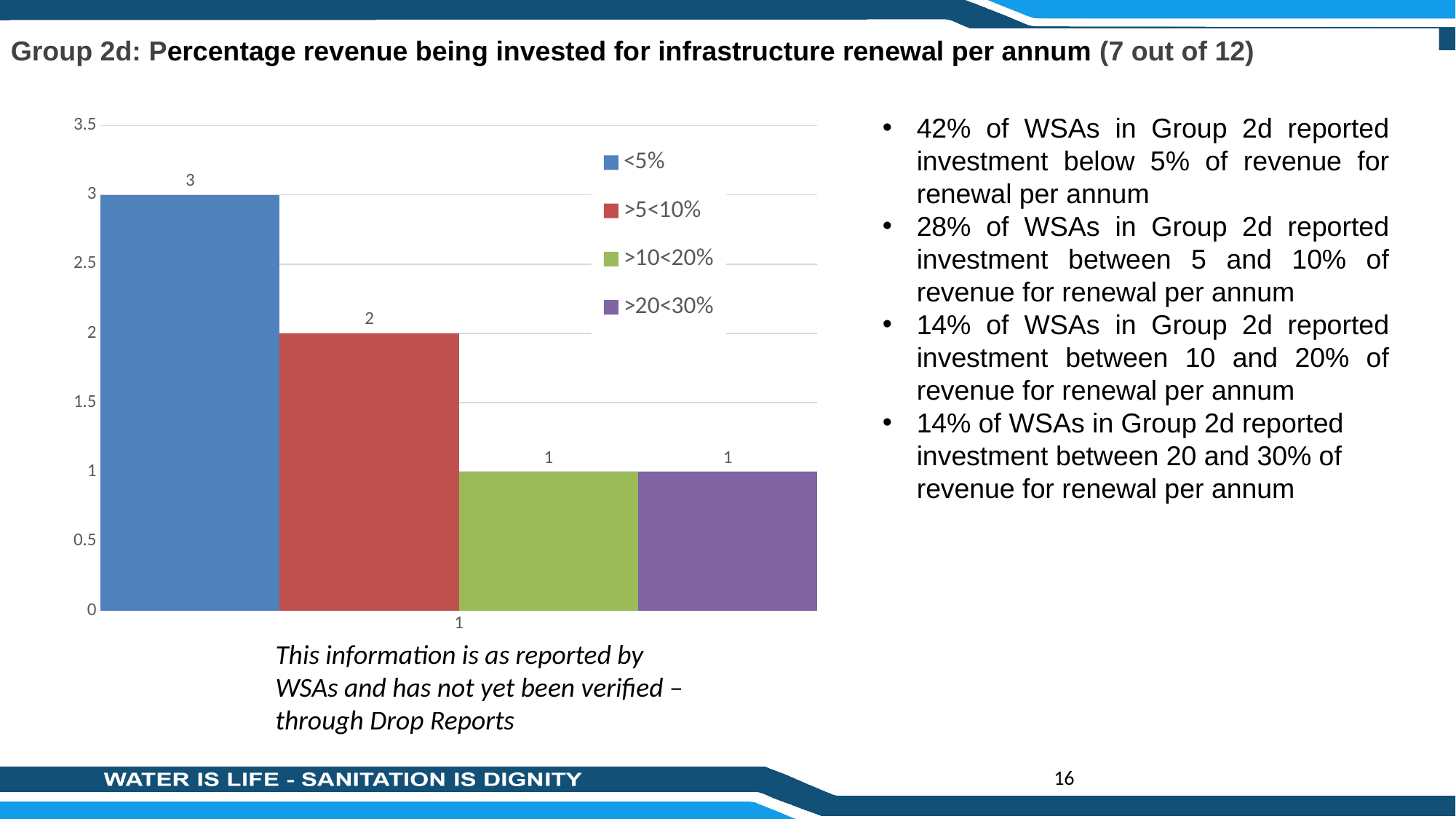
What kind of chart is shown on the slide? bar chart How many series does the legend list? 4 What colour is the bar for the >20<30% series? purple What is the value for the >10<20% series? 1 Which is larger, the value for >5<10% or the value for >10<20%? >5<10% What is the difference between the values for <5% and >20<30%? 2 What is the value for the >20<30% series? 1 What is the value for the >5<10% series? 2 What is the difference between the values for <5% and >5<10%? 1 What is the value for the <5% series? 3 Which series has the highest value? <5% Is the value for <5% greater or less than 2.5? greater